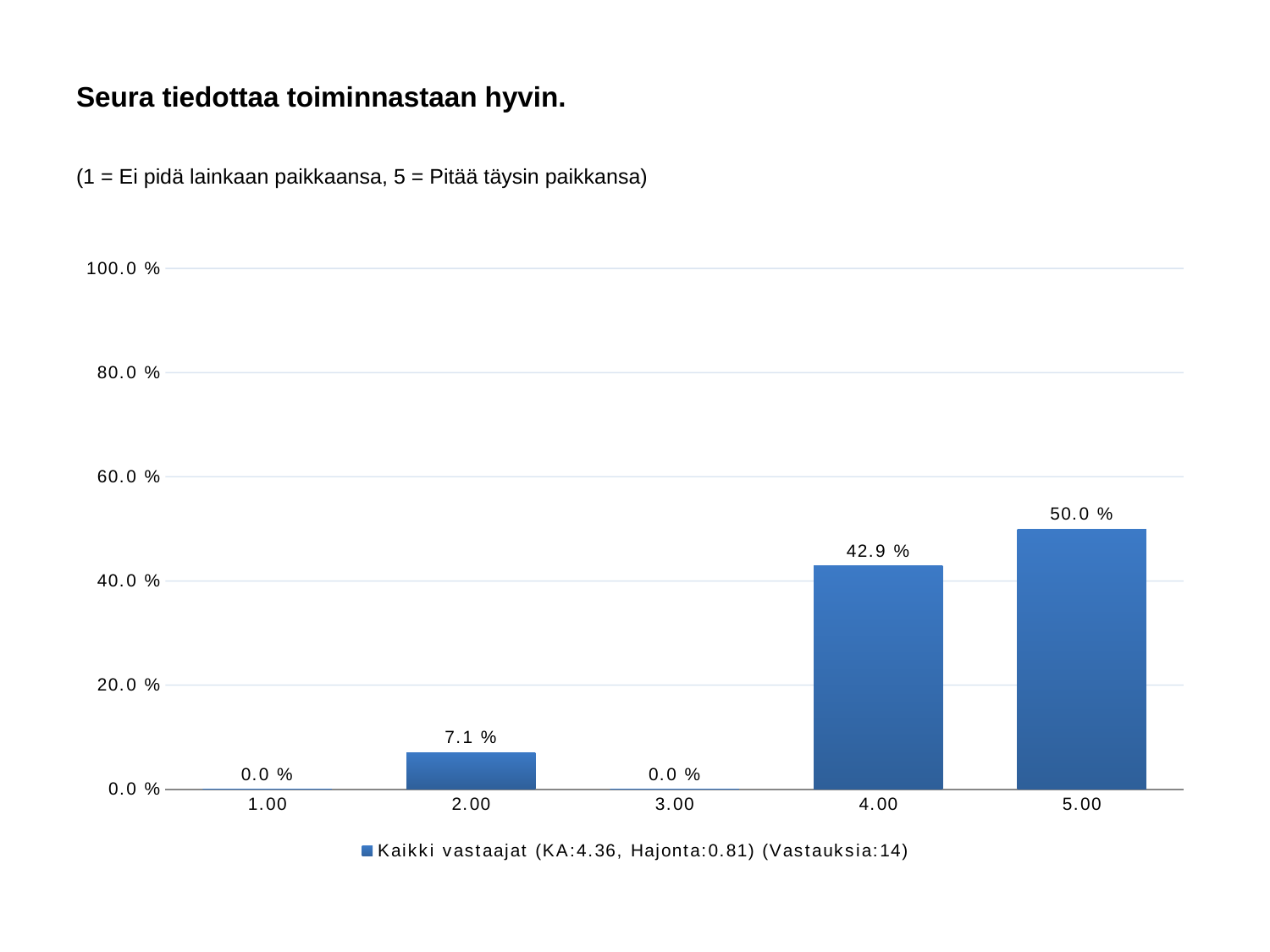
What is the value for category 4.00? 42.9 % Which category has the highest value? 5.00 How many series does the legend list? 1 How many categories are shown on the x axis? 5 What kind of chart is shown? bar chart What is the title of the slide? Seura tiedottaa toiminnastaan hyvin. Is the value for 5.00 greater or less than 40.0 %? greater Which is larger, the value for 2.00 or the value for 4.00? 4.00 What is the value for category 5.00? 50.0 % What is the value for category 2.00? 7.1 % What is the value for category 1.00? 0.0 % What is the difference between the values for 5.00 and 4.00? 7.1 %